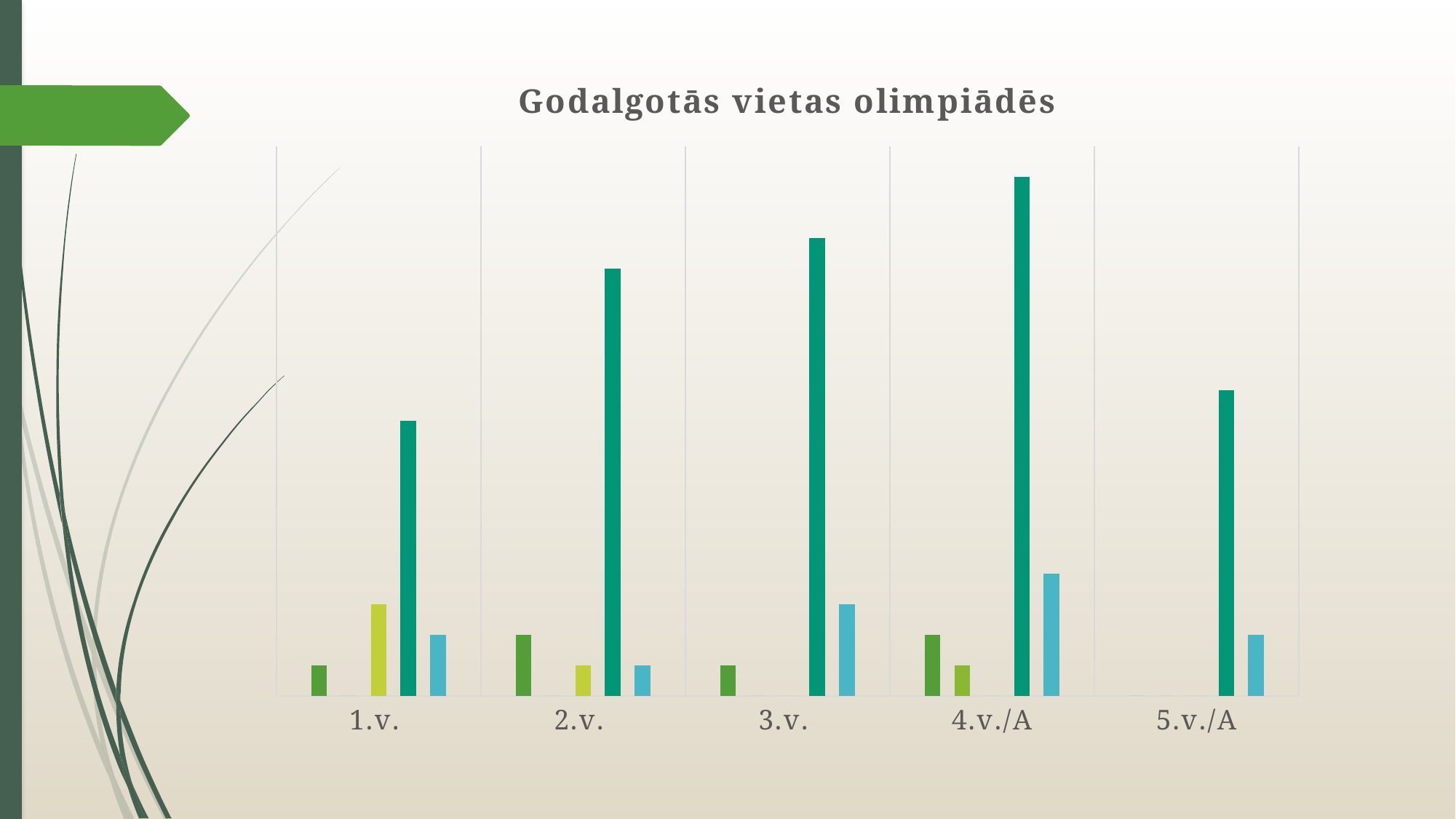
Which category has a taller tallest bar, 1.v. or 5.v./A? 5.v./A What is the title of the chart? Godalgotās vietas olimpiādēs Which category contains the tallest bar in the chart? 4.v./A Which category has a taller tallest bar, 2.v. or 3.v.? 3.v. How many categories are shown on the x axis of the chart? 5 Does the chart display a legend? No Which category has the lowest tallest bar in the chart? 1.v. What kind of chart is shown on the slide? bar chart Does the tallest bar in each group rise or fall from 1.v. through 4.v./A? rises